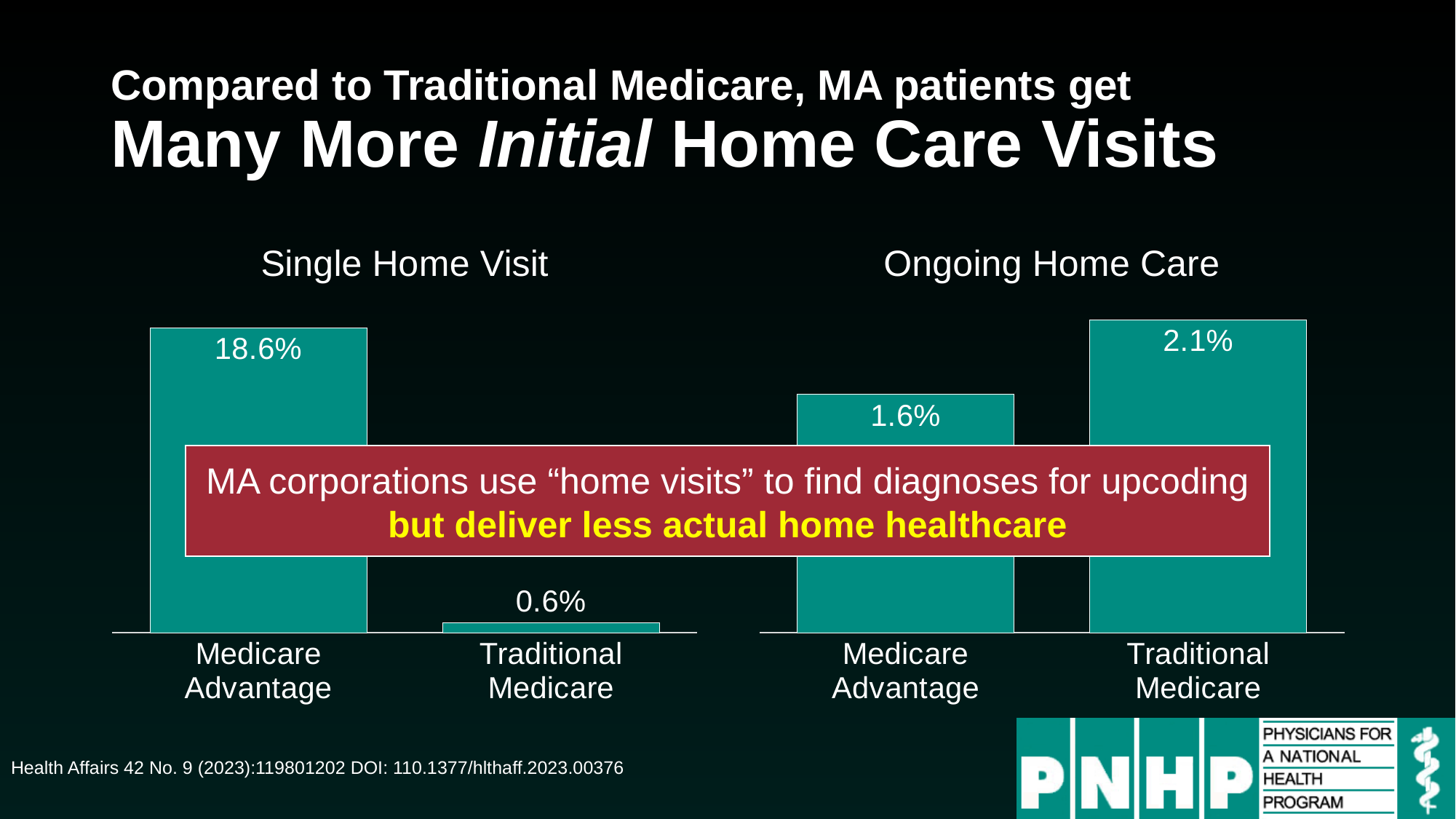
What kind of chart is the Ongoing Home Care chart? Bar chart In the Single Home Visit chart, what is the value for Medicare Advantage? 18.6% In the Single Home Visit chart, what is the difference between the Medicare Advantage and Traditional Medicare values? 18.0% In the Single Home Visit chart, what is the value for Traditional Medicare? 0.6% In the Ongoing Home Care chart, which category has the lowest value? Medicare Advantage How many categories are shown in the Single Home Visit chart? 2 In the Ongoing Home Care chart, what is the value for Medicare Advantage? 1.6% In the Ongoing Home Care chart, which is larger, Medicare Advantage or Traditional Medicare? Traditional Medicare What is the title of the chart on the right side of the slide? Ongoing Home Care In the Single Home Visit chart, which category has the highest value? Medicare Advantage In the Ongoing Home Care chart, what is the value for Traditional Medicare? 2.1% In the Ongoing Home Care chart, what is the difference between the Traditional Medicare and Medicare Advantage values? 0.5%